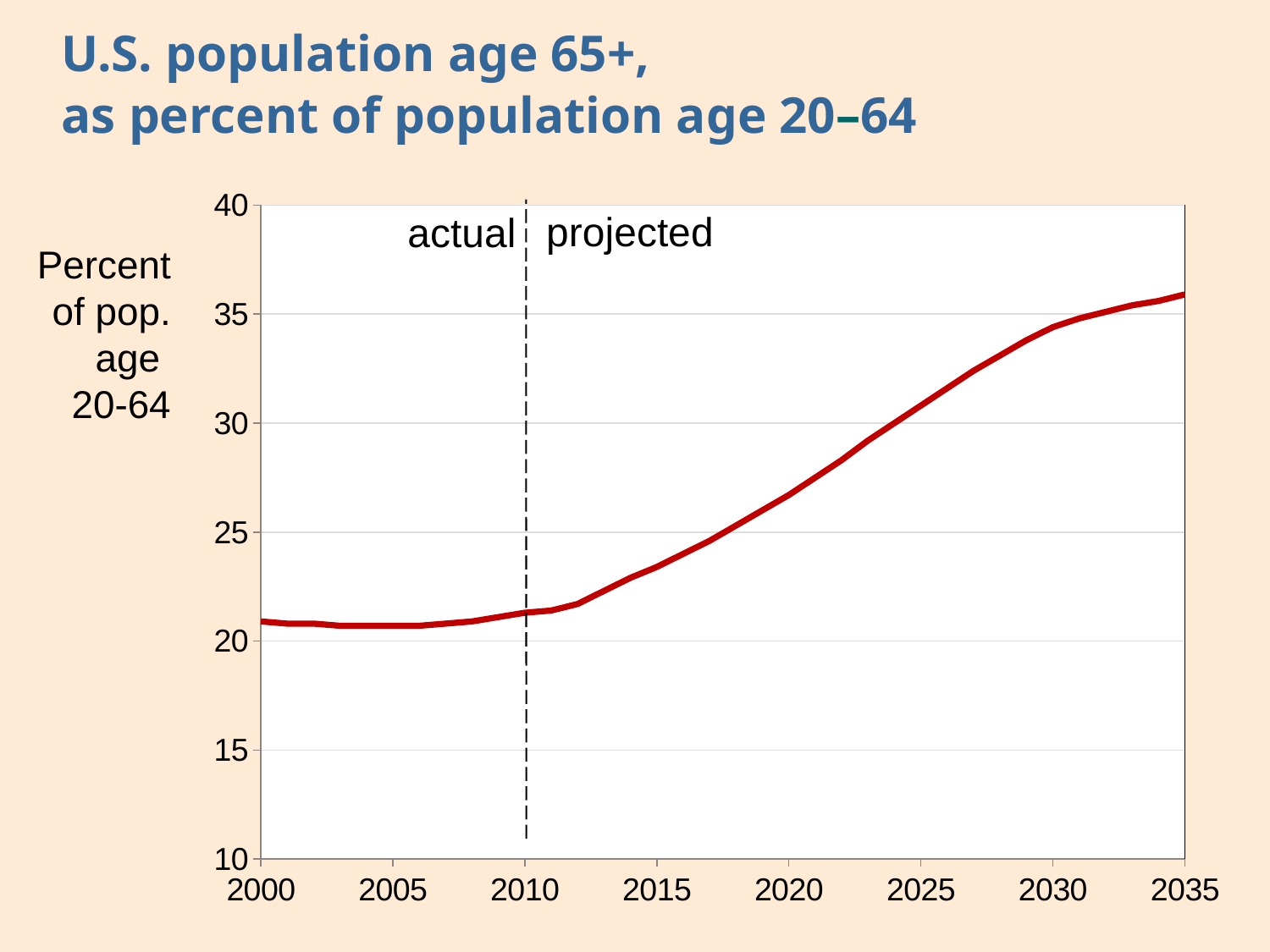
Is the value for 2015 greater or less than 25? less At which year does the dashed line separating 'actual' from 'projected' appear? 2010 Is the value for 2035 greater or less than 35? greater Is the value for 2010 greater or less than 20? greater What kind of chart is shown on the slide? line chart Which is larger, the value for 2000 or the value for 2035? 2035 Does the line rise or fall from 2010 to 2035? rise In which year shown on the x axis does the line reach its highest value? 2035